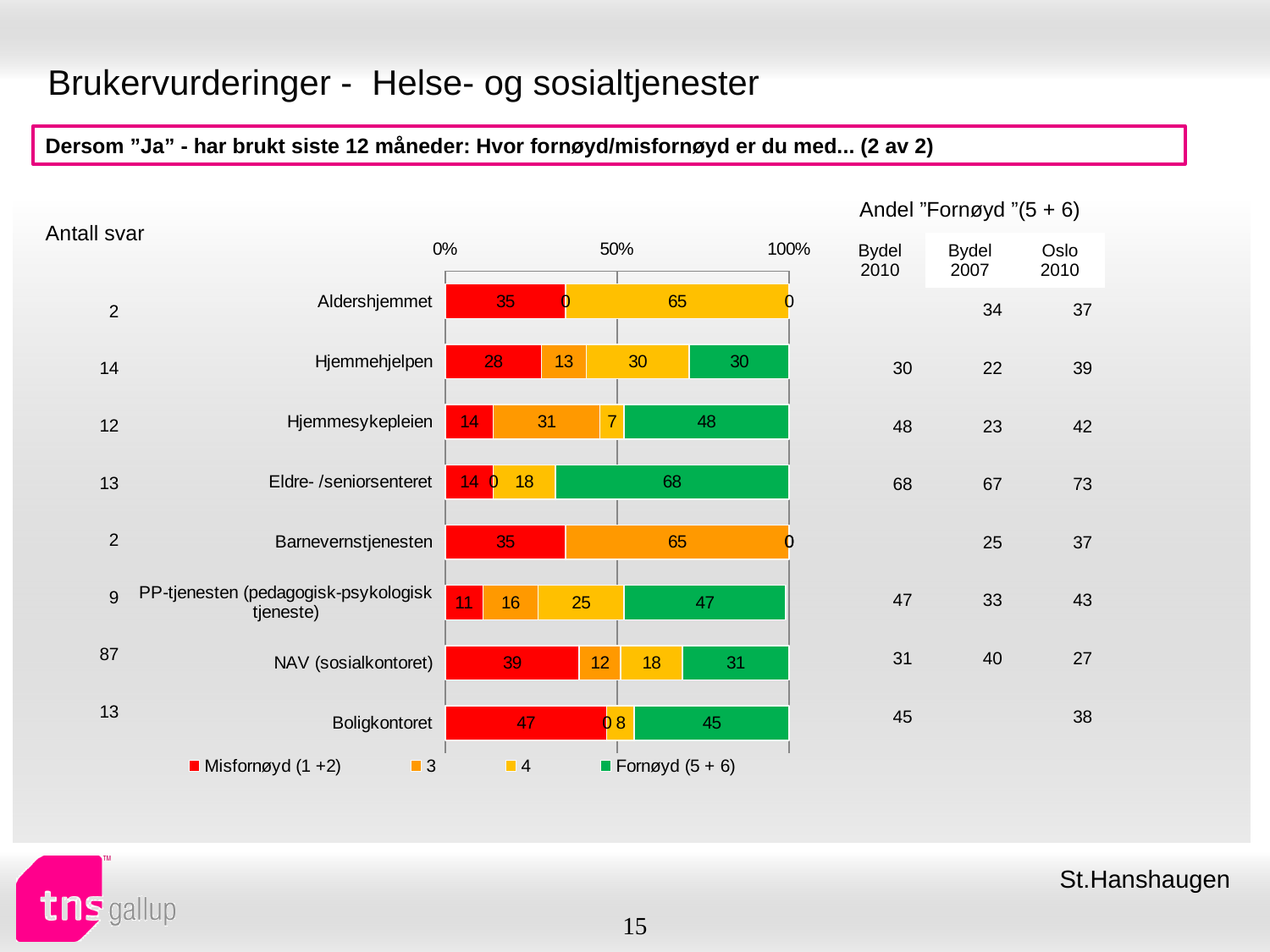
What kind of chart is shown on the slide? Stacked bar chart What is the difference between the Fornøyd (5 + 6) value for Eldre- /seniorsenteret and for NAV (sosialkontoret)? 37 Which category has the highest Fornøyd (5 + 6) value? Eldre- /seniorsenteret What is the value of the '3' segment for Hjemmesykepleien? 31 How many categories (bars) are shown in the chart? 8 How many series does the legend list? 4 What is the value of the Misfornøyd (1 +2) segment for NAV (sosialkontoret)? 39 Which has the larger Misfornøyd (1 +2) value, Boligkontoret or Hjemmehjelpen? Boligkontoret Which category has the lowest Misfornøyd (1 +2) value? PP-tjenesten (pedagogisk-psykologisk tjeneste) What is the value of the Fornøyd (5 + 6) segment for Hjemmesykepleien? 48 What is the first entry in the chart's legend? Misfornøyd (1 +2) What is the value of the '4' segment for PP-tjenesten (pedagogisk-psykologisk tjeneste)? 25